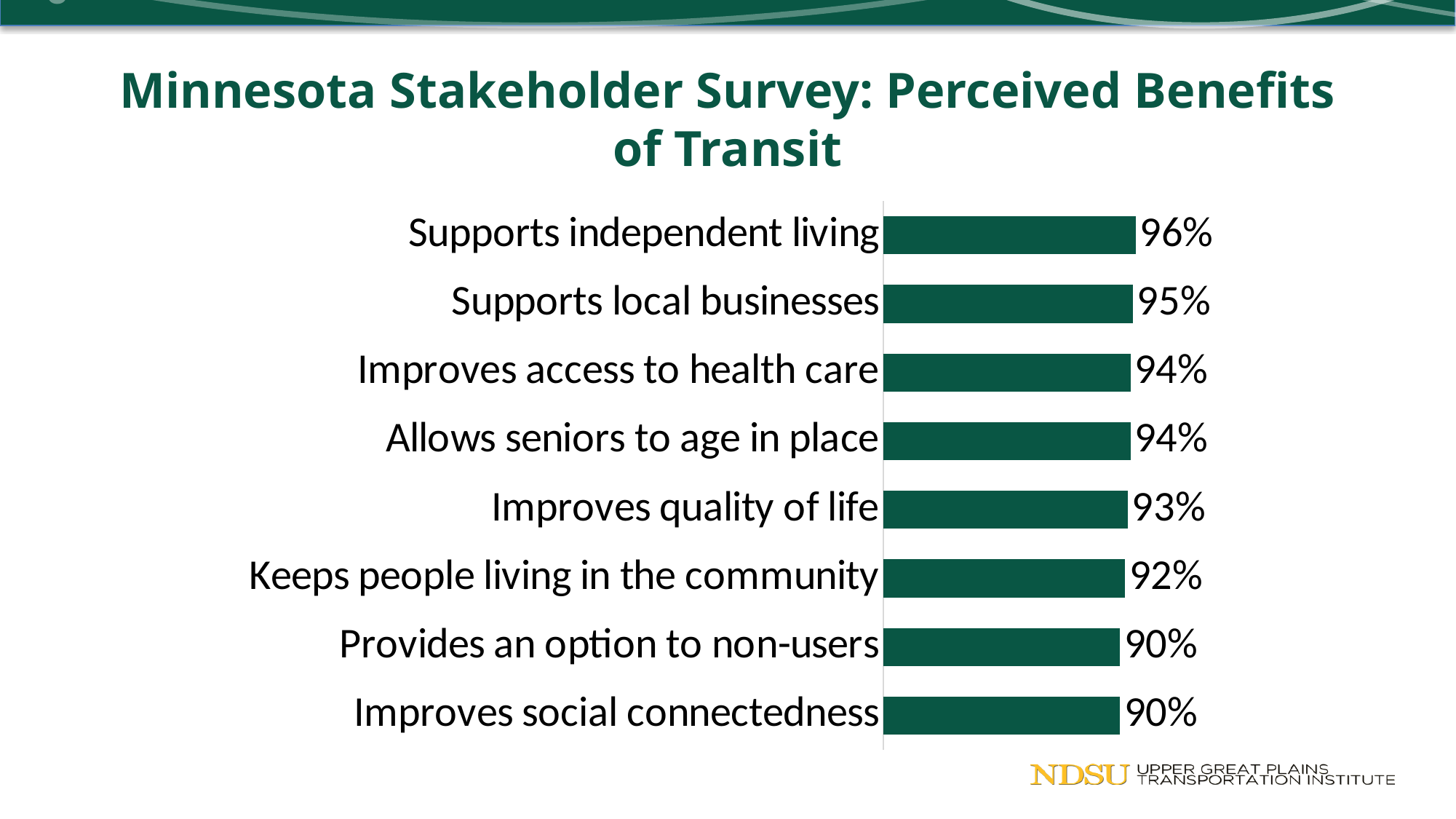
What is the title of the slide containing the chart? Minnesota Stakeholder Survey: Perceived Benefits of Transit How many perceived benefits are listed on the chart? 8 Which perceived benefit has the highest percentage? Supports independent living What percentage of respondents perceived 'Supports independent living' as a benefit of transit? 96% What is the value shown for 'Improves quality of life'? 93% What is the value shown for 'Keeps people living in the community'? 92% What is the lowest percentage shown on the chart? 90% Which two categories both have a value of 94%? Improves access to health care; Allows seniors to age in place What kind of chart is shown on the slide? Bar chart What is the value shown for 'Supports local businesses'? 95% Which has a larger value: 'Supports local businesses' or 'Improves quality of life'? Supports local businesses What is the difference between the values for 'Supports independent living' and 'Improves social connectedness'? 6%